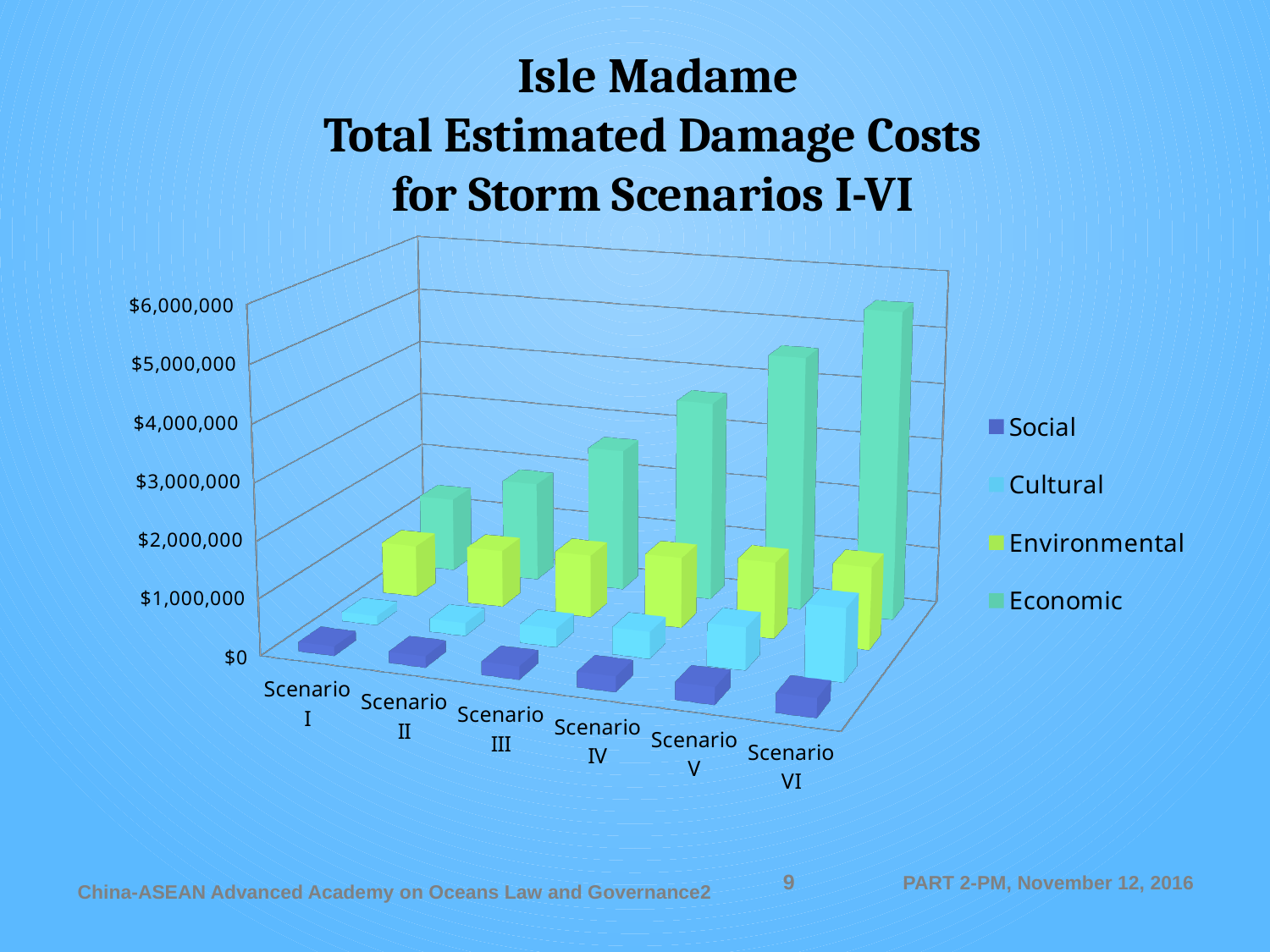
Is the Social value for Scenario I greater or less than $1,000,000? less What is the title of the chart? Isle Madame Total Estimated Damage Costs for Storm Scenarios I-VI What kind of chart is shown on the slide? bar chart Do the Economic damage costs rise or fall from Scenario I to Scenario VI? rise Is the Economic value for Scenario VI greater or less than $4,000,000? greater In which scenario is the Economic damage cost highest? Scenario VI Which is larger in Scenario I, the Environmental value or the Social value? Environmental How many series does the legend list? 4 How many storm scenarios are shown on the x axis? 6 In which scenario is the Economic damage cost lowest? Scenario I Which series has the tallest bar in every scenario? Economic Is the Economic value for Scenario I greater or less than $4,000,000? less